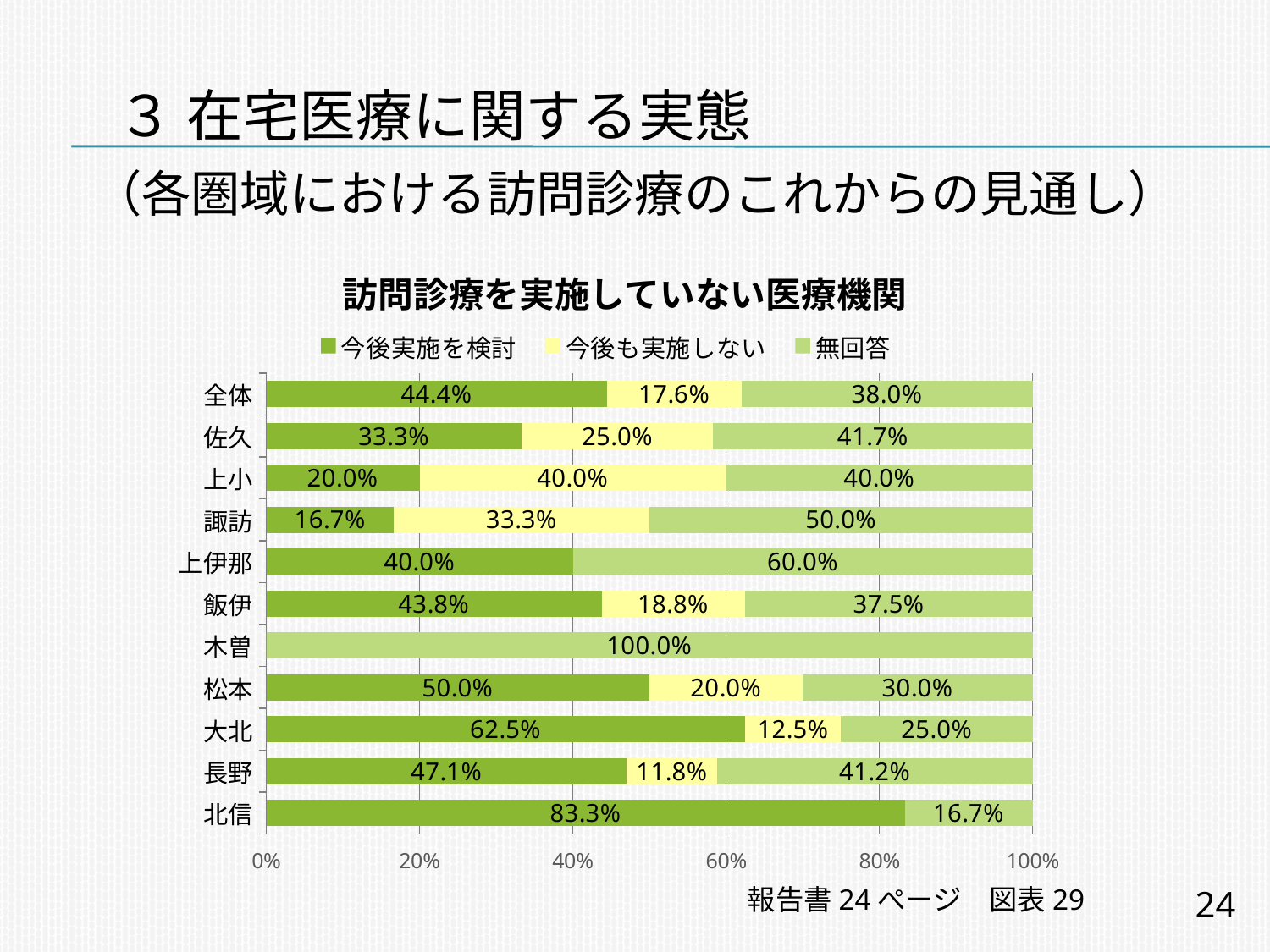
Which category has the highest value for 無回答? 木曽 Which category has the highest value for 今後実施を検討? 北信 Which category has the lowest value for 無回答? 北信 What is the difference between 今後実施を検討 and 今後も実施しない for 大北? 50.0% What is the value of 無回答 for 木曽? 100.0% What kind of chart is shown on the slide? Stacked bar chart Which is larger for 今後実施を検討: 松本 or 長野? 松本 What is the value of 今後実施を検討 for 全体? 44.4% How many categories are shown on the vertical axis? 11 What is the value of 無回答 for 諏訪? 50.0% How many series does the legend list? 3 What is the value of 今後も実施しない for 大北? 12.5%